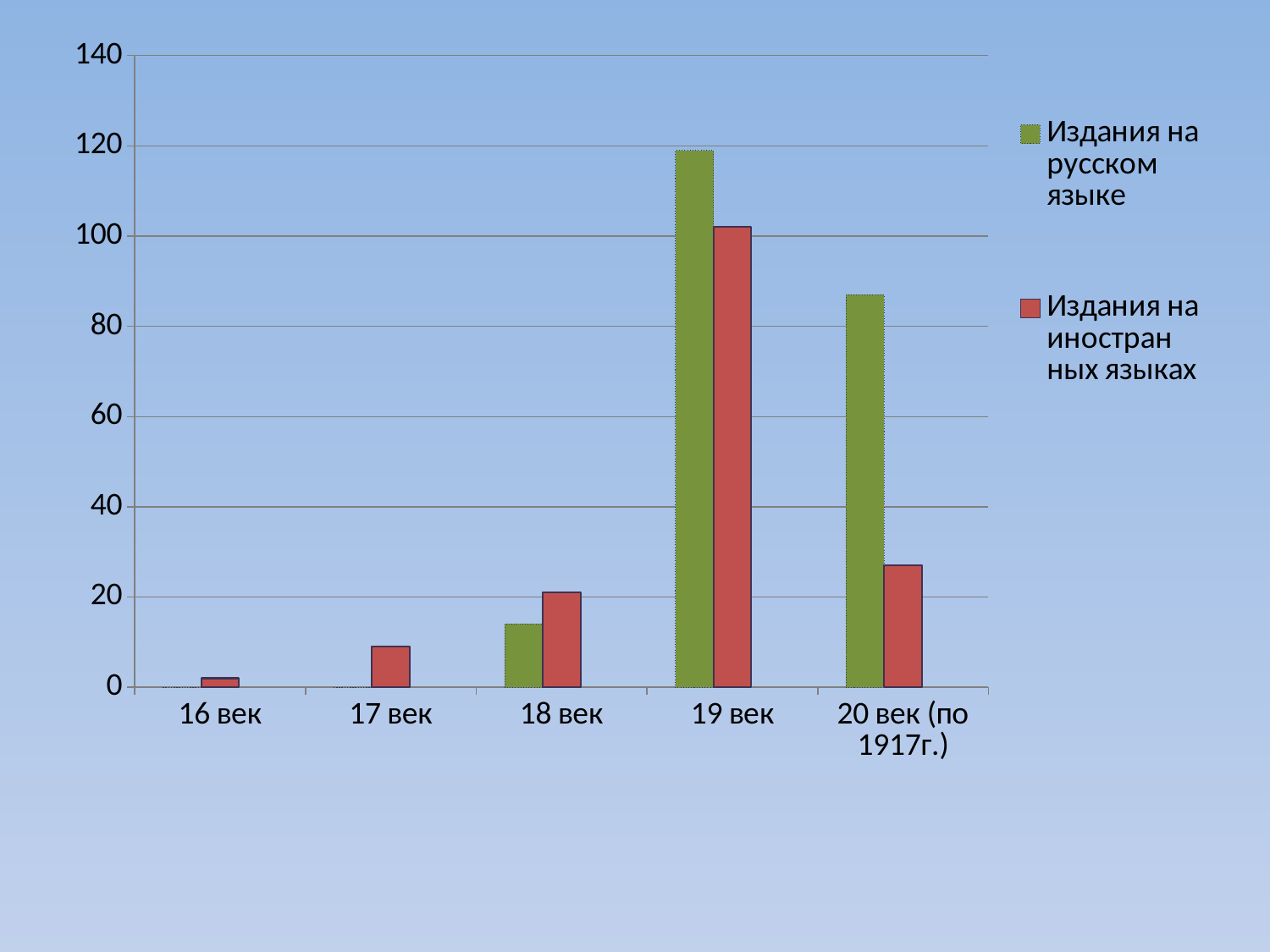
Is the value for Издания на русском языке in 19 век greater or less than 100? greater For 19 век, which series has the larger value: Издания на русском языке or Издания на иностранных языках? Издания на русском языке What colour are the bars for Издания на русском языке? green For 18 век, which series has the larger value: Издания на русском языке or Издания на иностранных языках? Издания на иностранных языках How many categories are shown on the x axis? 5 What kind of chart is shown on the slide? bar chart Which category has the lowest value for Издания на иностранных языках? 16 век Which category has the highest value for Издания на русском языке? 19 век For 20 век (по 1917г.), which series has the larger value: Издания на русском языке or Издания на иностранных языках? Издания на русском языке How many series does the legend list? 2 Is the value for Издания на иностранных языках in 20 век (по 1917г.) greater or less than 40? less Which category has the highest value for Издания на иностранных языках? 19 век